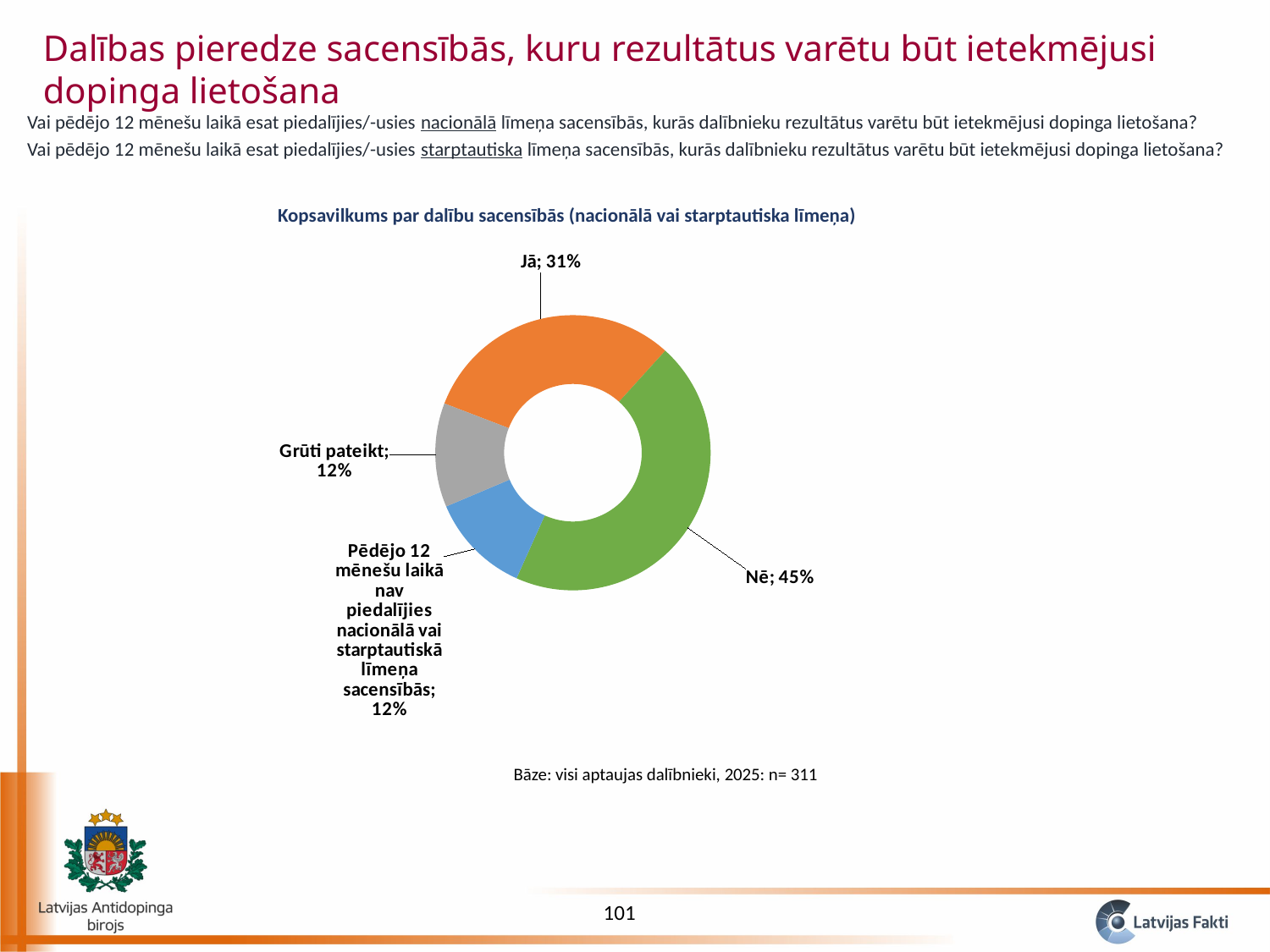
Which is larger, the share for "Jā" or the share for "Grūti pateikt"? Jā What is the combined share of "Grūti pateikt" and "Pēdējo 12 mēnešu laikā nav piedalījies nacionālā vai starptautiskā līmeņa sacensībās"? 24% What share of respondents answered "Grūti pateikt"? 12% How many categories are shown in the chart? 4 What share of respondents answered "Jā" in the chart? 31% What share of respondents answered "Nē"? 45% What share of respondents had not participated in national or international level competitions in the last 12 months ("Pēdējo 12 mēnešu laikā nav piedalījies...")? 12% What is the title of the chart? Kopsavilkums par dalību sacensībās (nacionālā vai starptautiska līmeņa) Which category has the largest share in the chart? Nē What colour is the "Nē" segment of the chart? Green What type of chart is shown on the slide? Doughnut (pie) chart What is the difference in percentage points between the "Nē" and "Jā" shares? 14